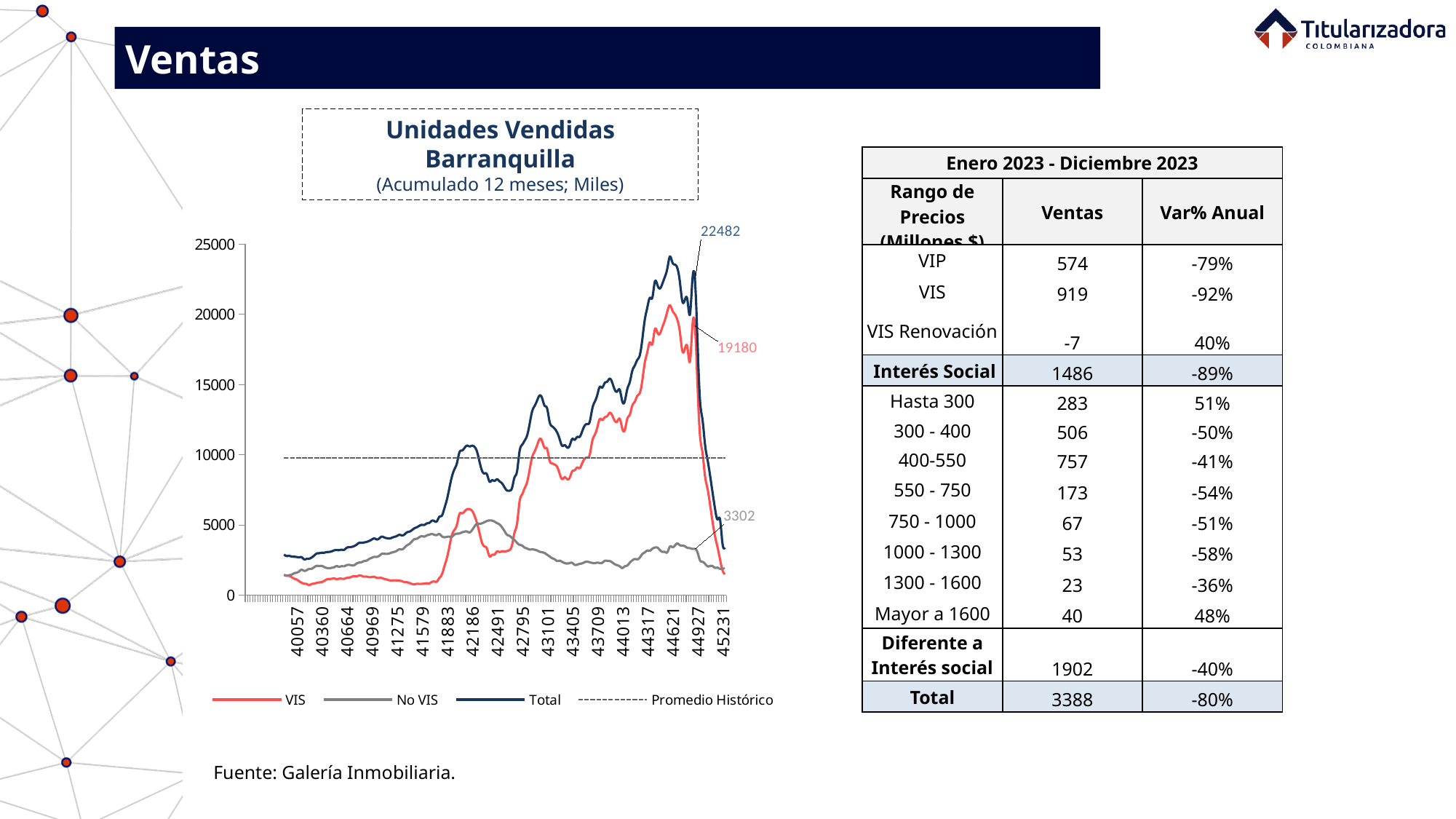
Which series reaches the highest value in the "Unidades Vendidas Barranquilla" chart? Total What is the difference between the labeled Total value (22482) and the labeled VIS value (19180) in the chart? 3302 What value is labeled on the VIS line in the "Unidades Vendidas Barranquilla" chart? 19180 What value is labeled on the Total line in the "Unidades Vendidas Barranquilla" chart? 22482 Is the peak of the Total line in the chart greater or less than 20000? greater Is the highest point of the No VIS line in the chart greater or less than 10000? less What are the four legend entries of the "Unidades Vendidas Barranquilla" chart? VIS, No VIS, Total, Promedio Histórico Does the Total line rise or fall over the final portion of the x axis in the chart? fall What kind of chart is shown under the title "Unidades Vendidas Barranquilla"? line chart What value is labeled on the No VIS line in the "Unidades Vendidas Barranquilla" chart? 3302 Which labeled value is larger in the chart: the VIS label or the No VIS label? VIS How many series does the legend of the "Unidades Vendidas Barranquilla" chart list? 4